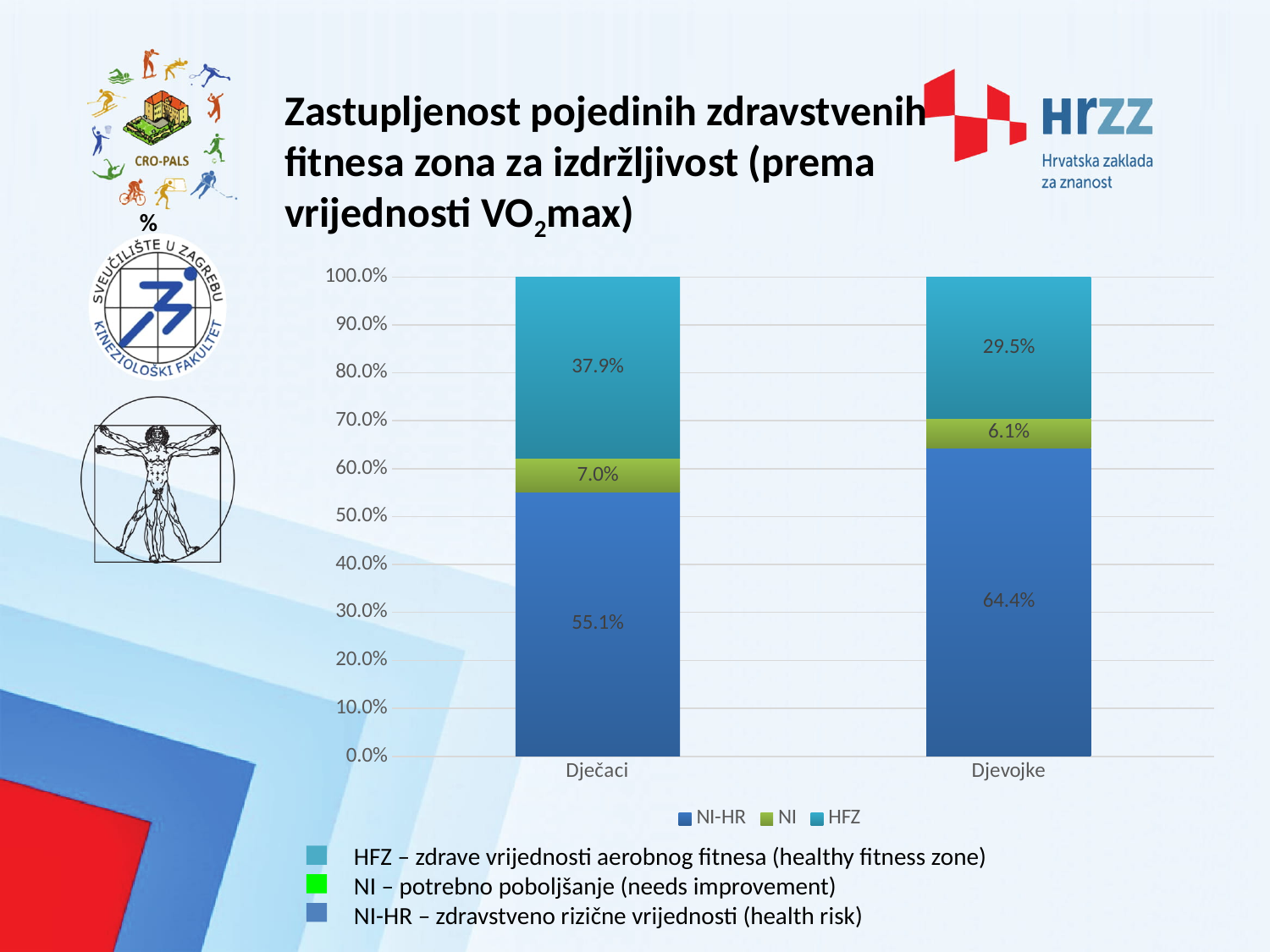
What kind of chart is shown on the slide? Stacked bar chart How many series does the legend list? 3 Which series is shown in green in the legend? NI What is the HFZ value for Djevojke? 29.5% What is the NI-HR value for Dječaci? 55.1% How many categories are shown on the x axis? 2 What is the difference between the HFZ values for Dječaci and Djevojke? 8.4% What is the NI-HR value for Djevojke? 64.4% Which category has the higher HFZ value, Dječaci or Djevojke? Dječaci Which category has the higher NI-HR value? Djevojke What is the difference between the NI-HR values for Djevojke and Dječaci? 9.3% What is the NI value for Dječaci? 7.0%